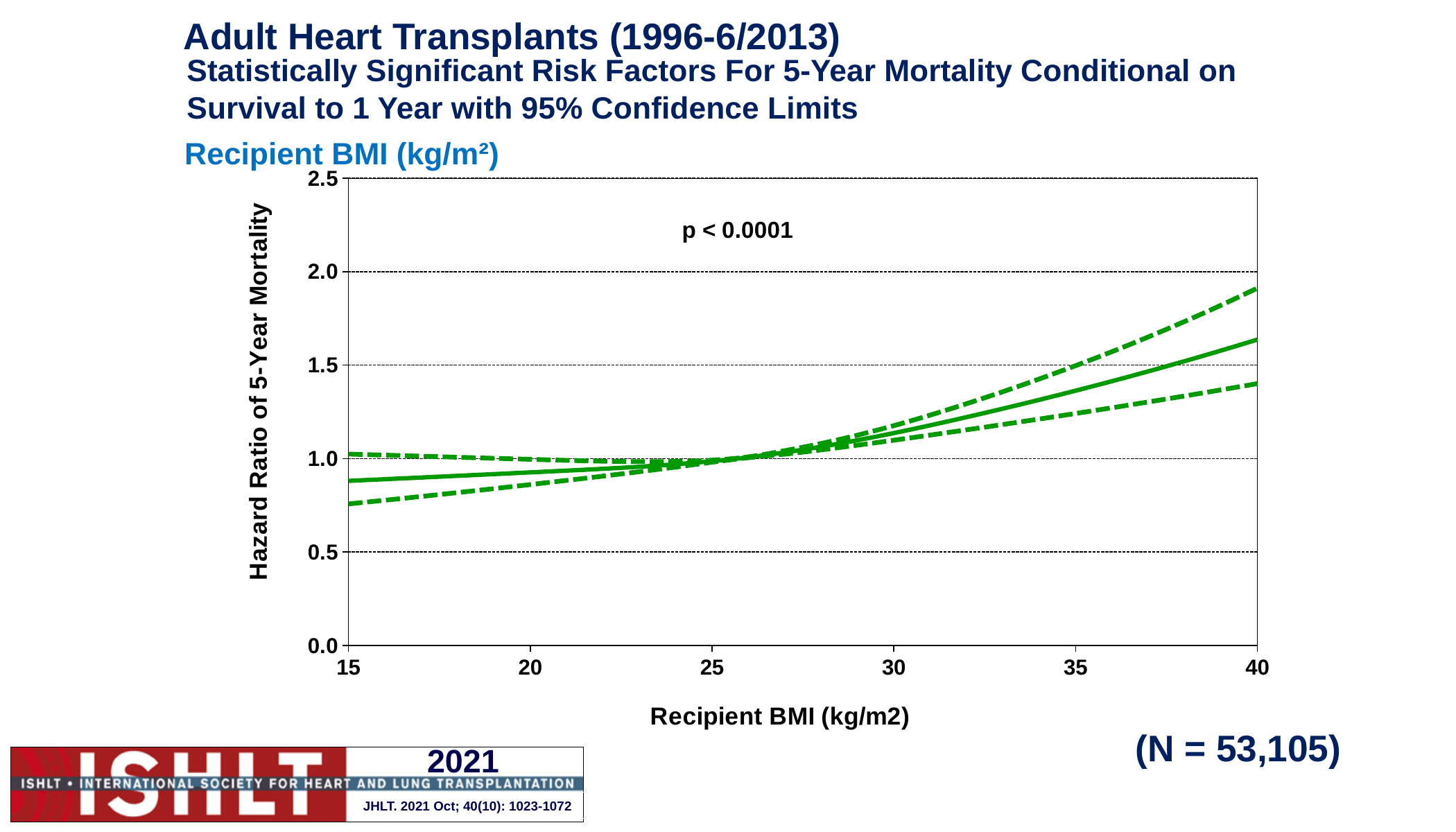
What kind of chart is shown on the slide? line chart How many lines are plotted on the chart? 3 Is the hazard ratio (solid line) at a recipient BMI of 15 greater or less than 1.0? less Does the hazard ratio of 5-year mortality rise or fall as recipient BMI increases from 25 to 40? rise At which recipient BMI value on the x axis is the hazard ratio (solid line) lowest? 15 At which recipient BMI value on the x axis is the hazard ratio (solid line) highest? 40 Is the lower confidence limit (lower dashed line) at a recipient BMI of 40 greater or less than 1.0? greater What p-value is printed on the chart? p < 0.0001 Is the upper confidence limit (upper dashed line) at a recipient BMI of 40 greater or less than 2.0? less What is the label of the y axis? Hazard Ratio of 5-Year Mortality